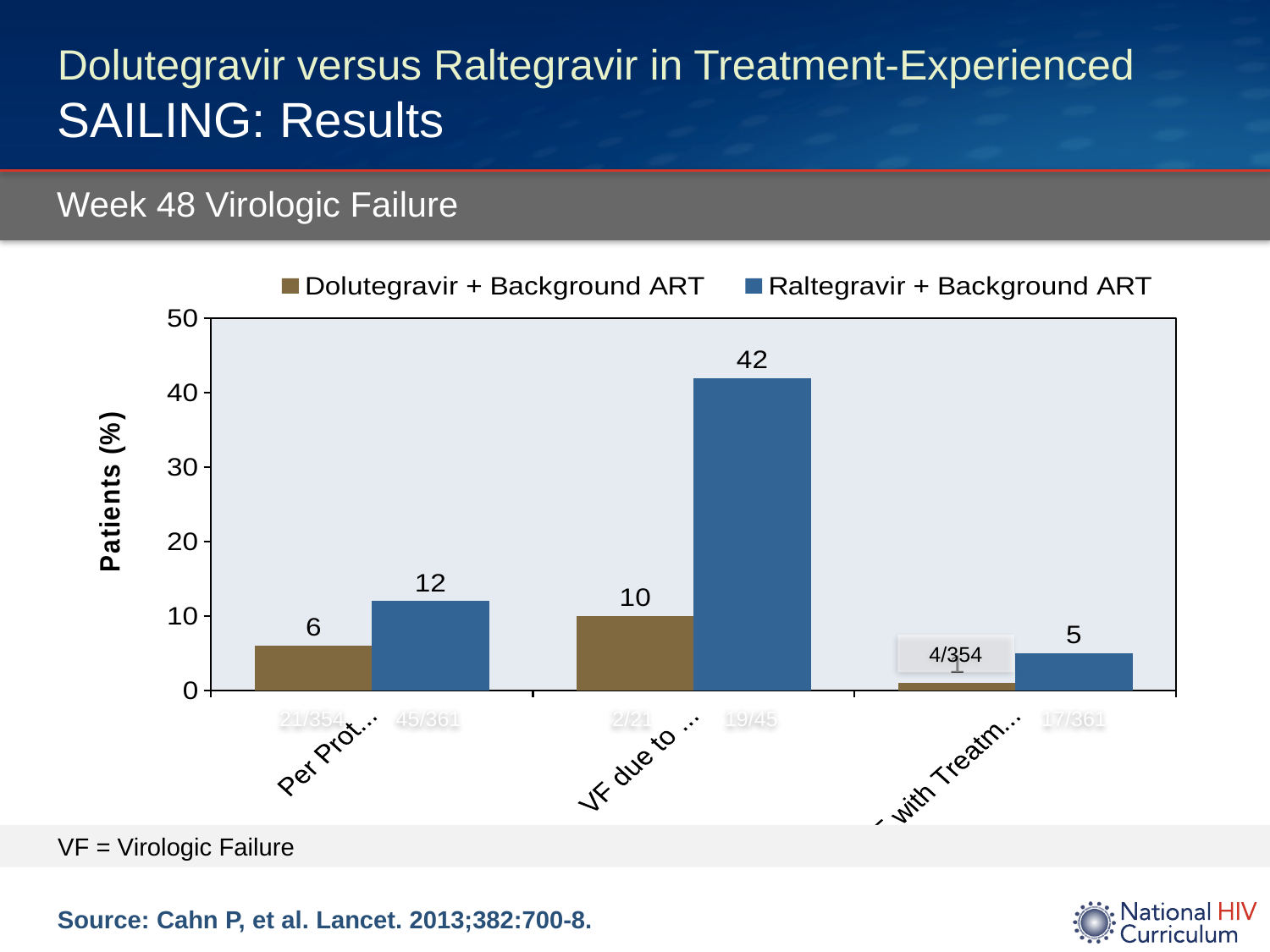
Which bar has the highest value on the chart? Raltegravir + Background ART in the middle group (42) What type of chart is shown on the slide? Bar chart What is the value for Raltegravir + Background ART in the rightmost group of bars? 5 How many groups of bars (categories) are plotted on the x axis? 3 What is the difference between the Raltegravir + Background ART and Dolutegravir + Background ART values in the leftmost group of bars? 6 Is the value for Raltegravir + Background ART in the middle group greater or less than 40? greater What is the value for Dolutegravir + Background ART in the leftmost group of bars? 6 What is the label on the y axis of the chart? Patients (%) In the leftmost group of bars, which series has the larger value? Raltegravir + Background ART What is the difference between the Raltegravir + Background ART and Dolutegravir + Background ART values in the middle group of bars? 32 What is the value for Raltegravir + Background ART in the middle group of bars? 42 How many series does the chart legend list? 2